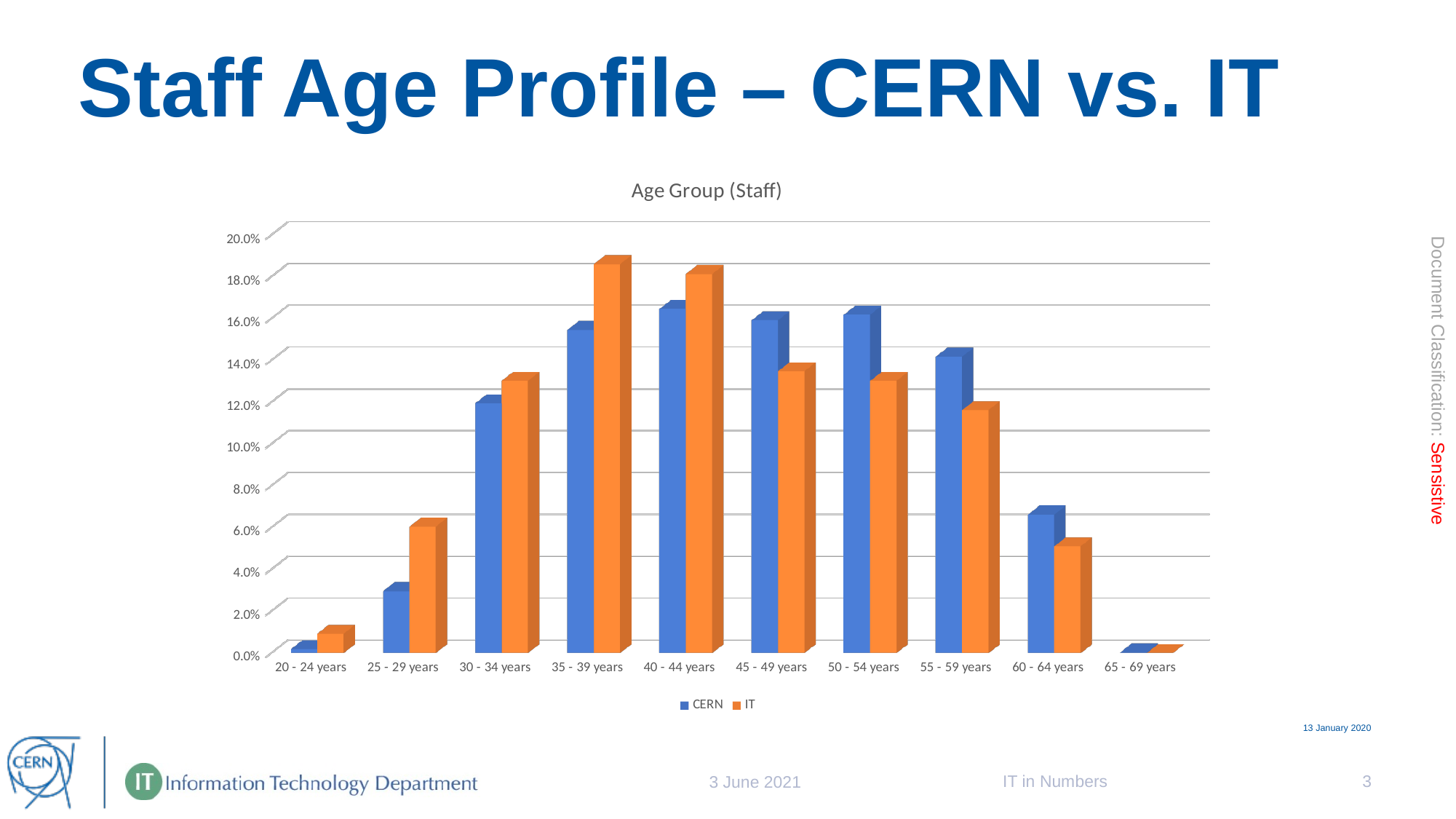
Which age group has the highest value for the IT series? 35 - 39 years Which age group has the lowest value for the CERN series? 65 - 69 years For the 35 - 39 years group, which series has the larger value, CERN or IT? IT What kind of chart is shown on the slide? Bar chart Is the IT value for 35 - 39 years greater or less than 18.0%? greater Is the IT value for 55 - 59 years greater or less than 10.0%? greater What is the title of the chart? Age Group (Staff) How many series does the legend list? 2 How many age groups are shown on the x axis? 10 For the 55 - 59 years group, which series has the larger value, CERN or IT? CERN Which colour represents the IT series? Orange Is the CERN value for 25 - 29 years greater or less than 4.0%? less